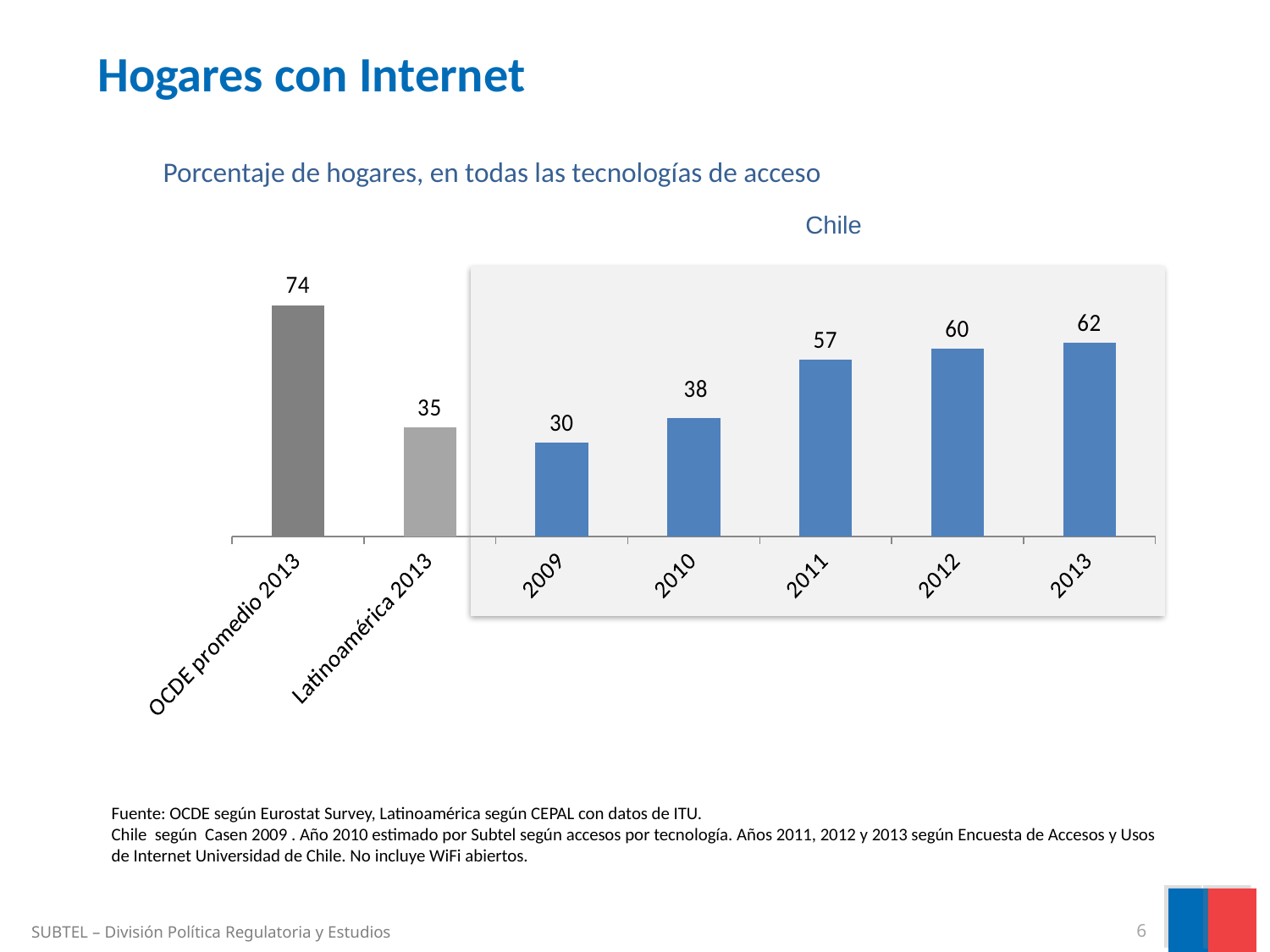
How many bars are plotted in the chart? 7 What is the value for Chile in 2009? 30 Which category has the lowest value in the chart? 2009 What kind of chart is shown on the slide? Bar chart What is the value for OCDE promedio 2013? 74 Do the values for Chile rise or fall from 2009 to 2013? Rise Which category has the highest value in the chart? OCDE promedio 2013 What is the difference between the OCDE promedio 2013 value and the Chile 2013 value? 12 Which is larger, the value for Latinoamérica 2013 or the value for Chile in 2010? Chile in 2010 What is the value for Chile in 2013? 62 What is the difference between the Chile 2013 value and the Chile 2009 value? 32 What is the value for Latinoamérica 2013? 35